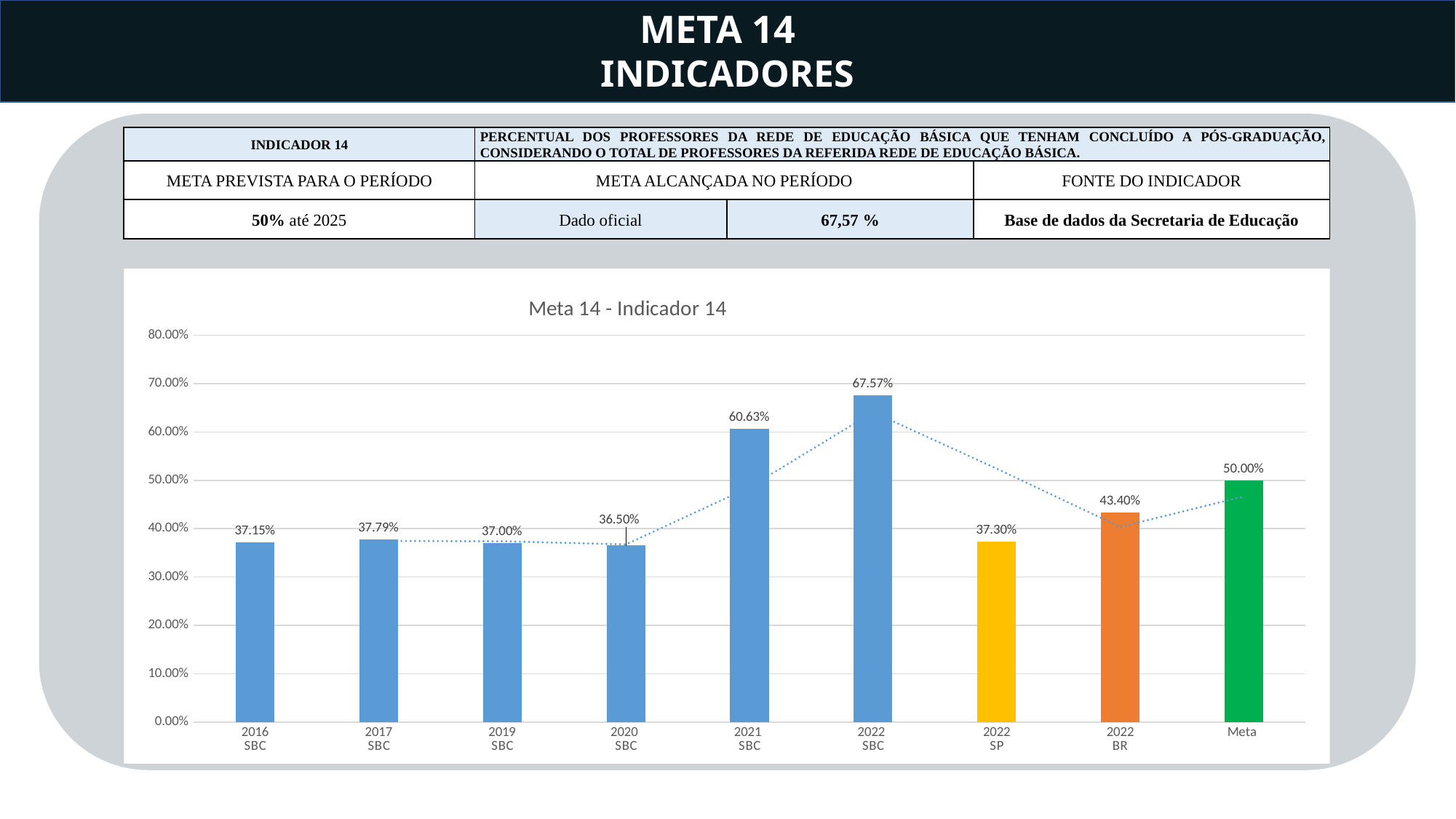
What is the difference between the values for 2022 SBC and 2021 SBC? 6.94% How many bars are plotted in the chart? 9 What is the value for 2022 SBC in the Meta 14 - Indicador 14 chart? 67.57% What kind of chart is shown on the slide? Bar chart Which category has the lowest value in the chart? 2020 SBC Which category has the highest value in the chart? 2022 SBC Which is larger, the value for 2022 BR or the value for 2022 SP? 2022 BR What is the value for 2020 SBC? 36.50% What is the difference between the Meta value and the 2022 BR value? 6.60% What is the value for 2022 BR in the chart? 43.40% What is the value shown for the Meta bar? 50.00% What is the title of the chart? Meta 14 - Indicador 14